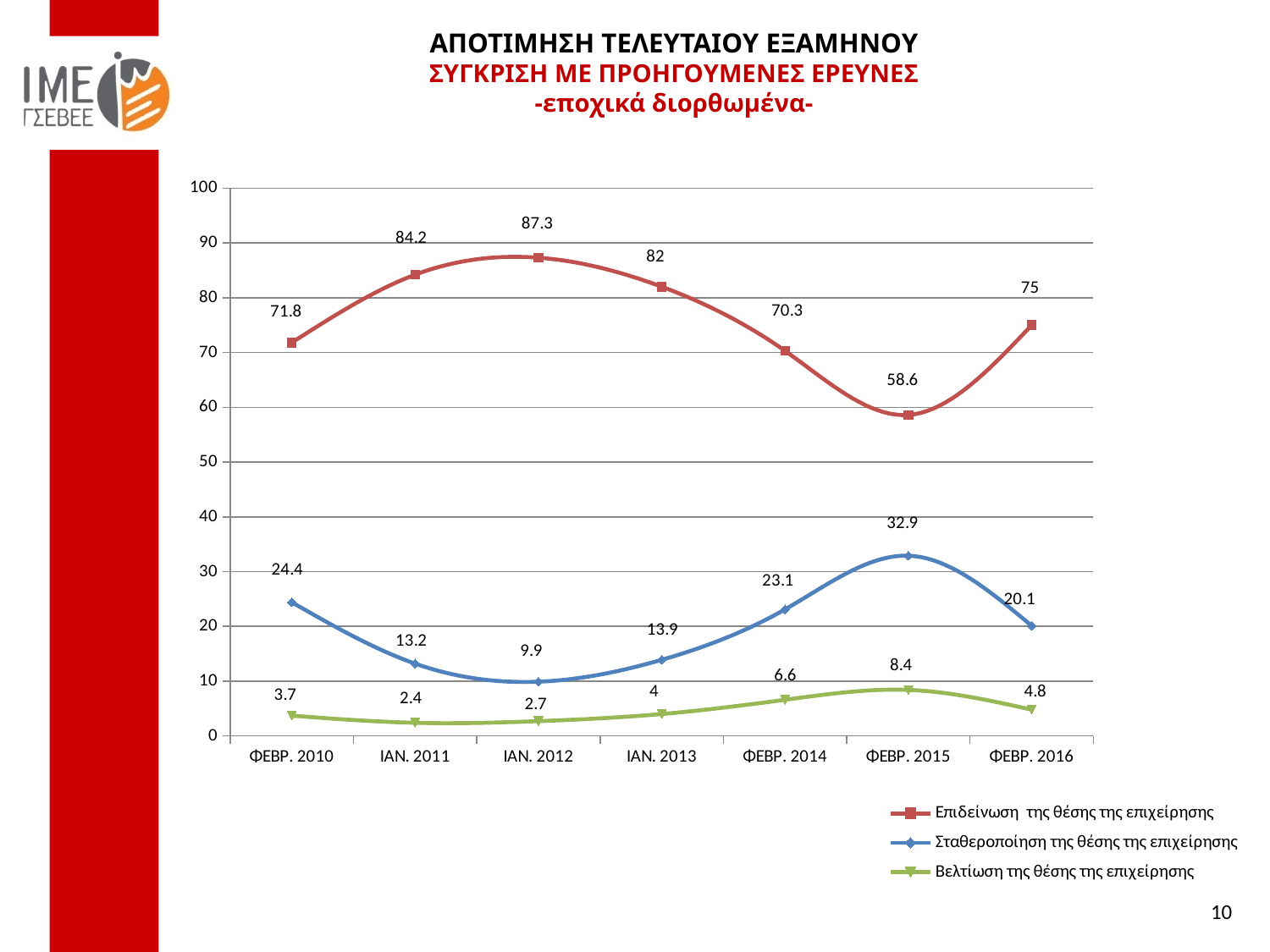
What is the value of Σταθεροποίηση της θέσης της επιχείρησης for ΦΕΒΡ. 2015? 32.9 In which period does Επιδείνωση της θέσης της επιχείρησης reach its lowest value? ΦΕΒΡ. 2015 What is the value of Βελτίωση της θέσης της επιχείρησης for ΙΑΝ. 2011? 2.4 In which period does Σταθεροποίηση της θέσης της επιχείρησης reach its highest value? ΦΕΒΡ. 2015 Is the Επιδείνωση value for ΦΕΒΡ. 2016 greater or less than 70? greater What is the difference between the Επιδείνωση values for ΙΑΝ. 2012 and ΦΕΒΡ. 2015? 28.7 How many time periods are shown on the x axis? 7 Does the Επιδείνωση series rise or fall from ΙΑΝ. 2012 to ΦΕΒΡ. 2015? fall Which is larger: Σταθεροποίηση for ΦΕΒΡ. 2014 or for ΦΕΒΡ. 2016? ΦΕΒΡ. 2014 What is the value of Επιδείνωση της θέσης της επιχείρησης for ΙΑΝ. 2012? 87.3 How many series does the legend list? 3 What kind of chart is shown on the slide? line chart